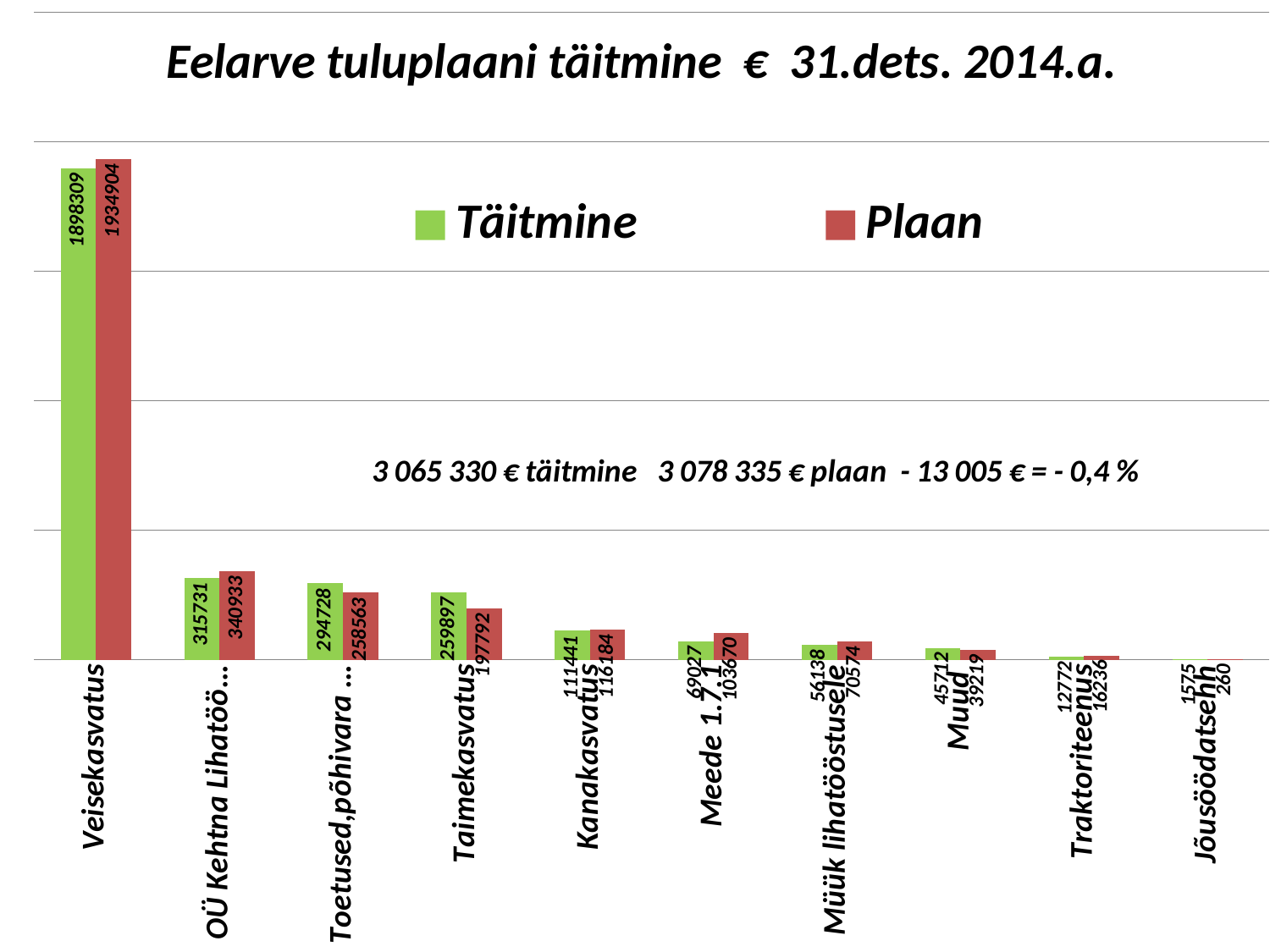
What kind of chart is shown on the slide? Bar chart How many series does the legend list? 2 How many categories are shown on the x axis? 10 What is the Täitmine value for Kanakasvatus? 111441 What is the Täitmine value for Veisekasvatus? 1898309 What is the Plaan value for Veisekasvatus? 1934904 What is the Plaan value for Taimekasvatus? 197792 For Taimekasvatus, which is larger: Täitmine or Plaan? Täitmine Which category has the lowest Plaan value? Jõusöödatsehh What is the Täitmine value for Muud? 45712 Which category has the highest Täitmine value? Veisekasvatus What is the difference between the Plaan and Täitmine values for Veisekasvatus? 36595